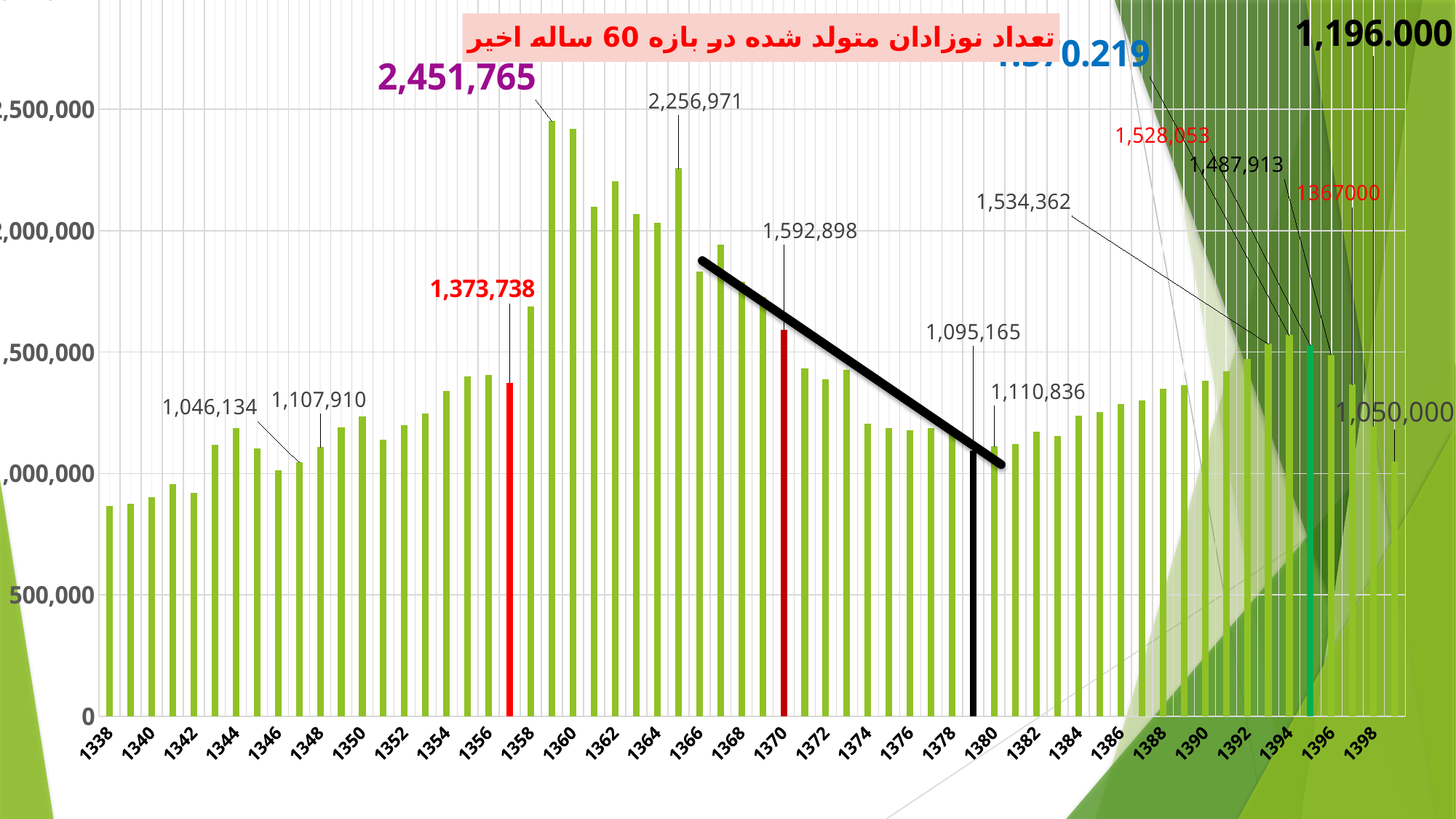
Do the values rise or fall along the x axis from 1366 to 1379? fall Which is larger, the value labeled 2,451,765 or the value labeled 2,256,971? 2,451,765 What value is labeled on the first (left) red bar, at 1357? 1,373,738 What value is labeled on the second red bar, at 1370? 1,592,898 What value is labeled on the black bar at 1379? 1,095,165 Is the value for 1338 greater or less than 1,000,000? less What colour are the two highlighted bars at 1357 and 1370? red What kind of chart is shown on the slide? bar chart What is the highest value labeled on the chart? 2,451,765 What is the difference between the peak value 2,451,765 and the red bar value 1,373,738? 1,078,027 What is the difference between the labeled values 1,110,836 and 1,095,165? 15,671 Is the value for 1360 greater or less than 2,000,000? greater